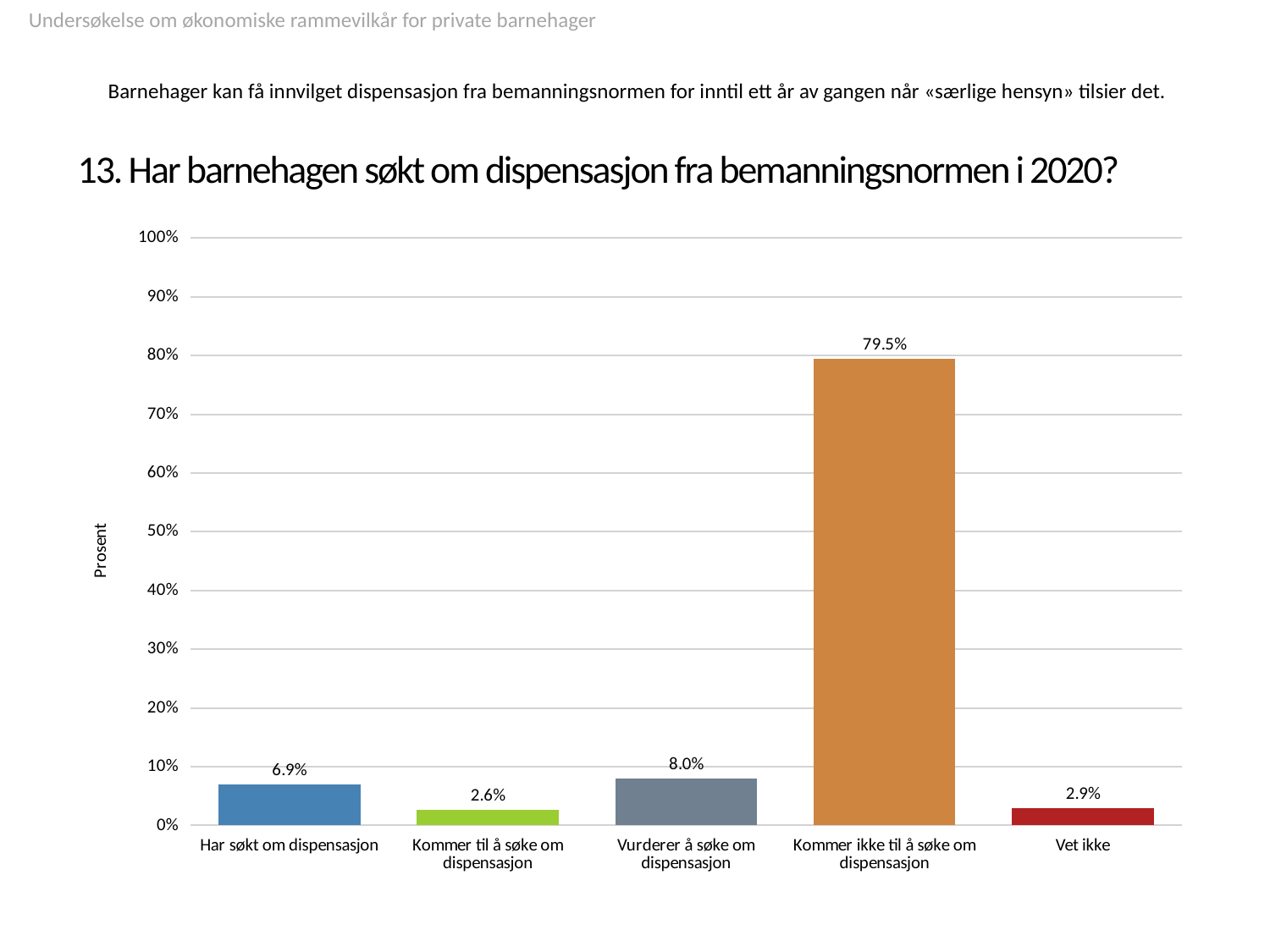
Which category has the highest value? Kommer ikke til å søke om dispensasjon What is the title of the chart? 13. Har barnehagen søkt om dispensasjon fra bemanningsnormen i 2020? How many categories are shown on the x axis? 5 What is the label of the y axis? Prosent What is the value for "Kommer ikke til å søke om dispensasjon"? 79.5% What percentage of respondents answered "Har søkt om dispensasjon"? 6.9% Which category has the lowest value? Kommer til å søke om dispensasjon Which is larger: "Vet ikke" or "Kommer til å søke om dispensasjon"? Vet ikke What is the difference between "Vurderer å søke om dispensasjon" and "Har søkt om dispensasjon"? 1.1% What kind of chart is shown on the slide? Bar chart What is the value for "Vet ikke"? 2.9% Is the value for "Kommer ikke til å søke om dispensasjon" greater or less than 70%? greater